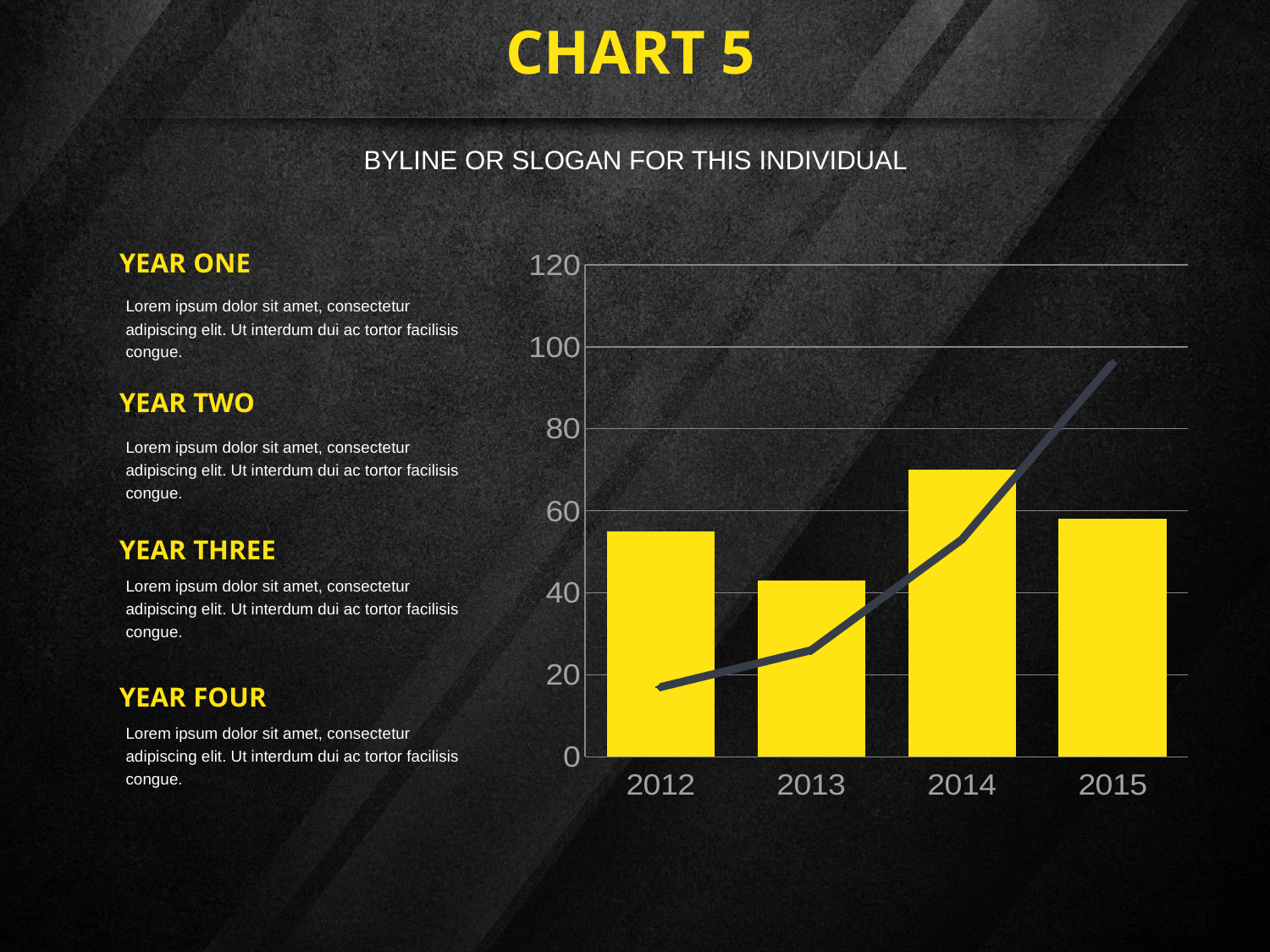
Is the bar value for 2012 greater or less than 60? less Is the bar value for 2013 greater or less than 60? less Is the bar value for 2014 greater or less than 60? greater Which year has the tallest bar? 2014 Which year has the shortest bar? 2013 What kind of chart is shown on the slide? A combination bar and line chart Is the bar for 2014 taller or shorter than the bar for 2013? taller How many years are shown on the x axis of the chart? 4 Does the line rise or fall from 2012 to 2015? rises What is the highest value shown on the vertical axis of the chart? 120